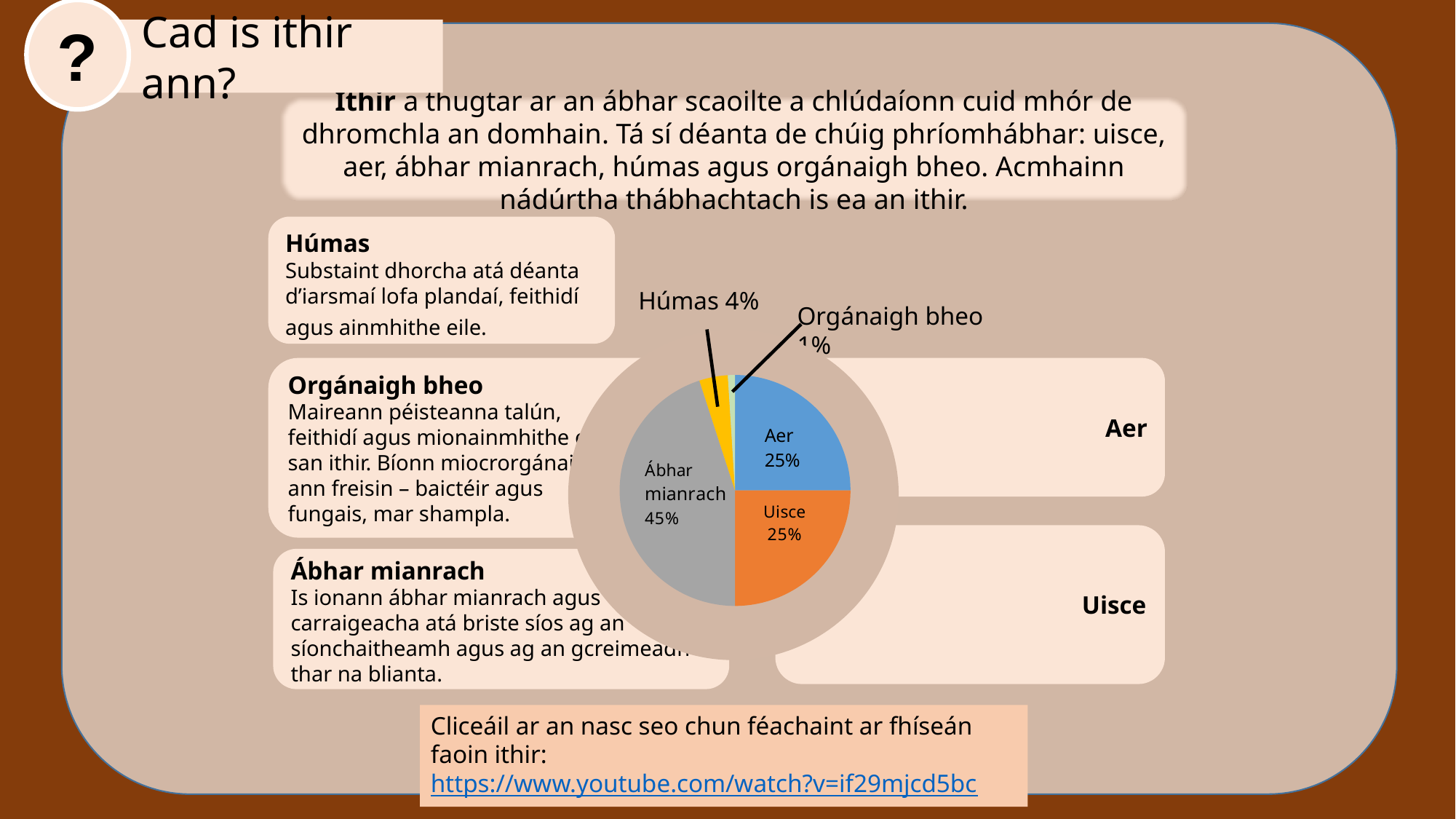
How many slices does the pie chart have? 5 Which slice of the pie chart is the largest? Ábhar mianrach What is the difference in percentage points between Húmas and Orgánaigh bheo in the pie chart? 3 What percentage of the pie chart is Húmas? 4% What percentage of the pie chart is Aer? 25% What kind of chart is shown on the slide? pie chart Which slice of the pie chart is the smallest? Orgánaigh bheo What percentage of the pie chart is Uisce? 25% What is the difference in percentage points between Ábhar mianrach and Aer in the pie chart? 20 What colour is the Ábhar mianrach slice in the pie chart? grey What percentage of the pie chart is Ábhar mianrach? 45% Which is larger in the pie chart, Húmas or Uisce? Uisce